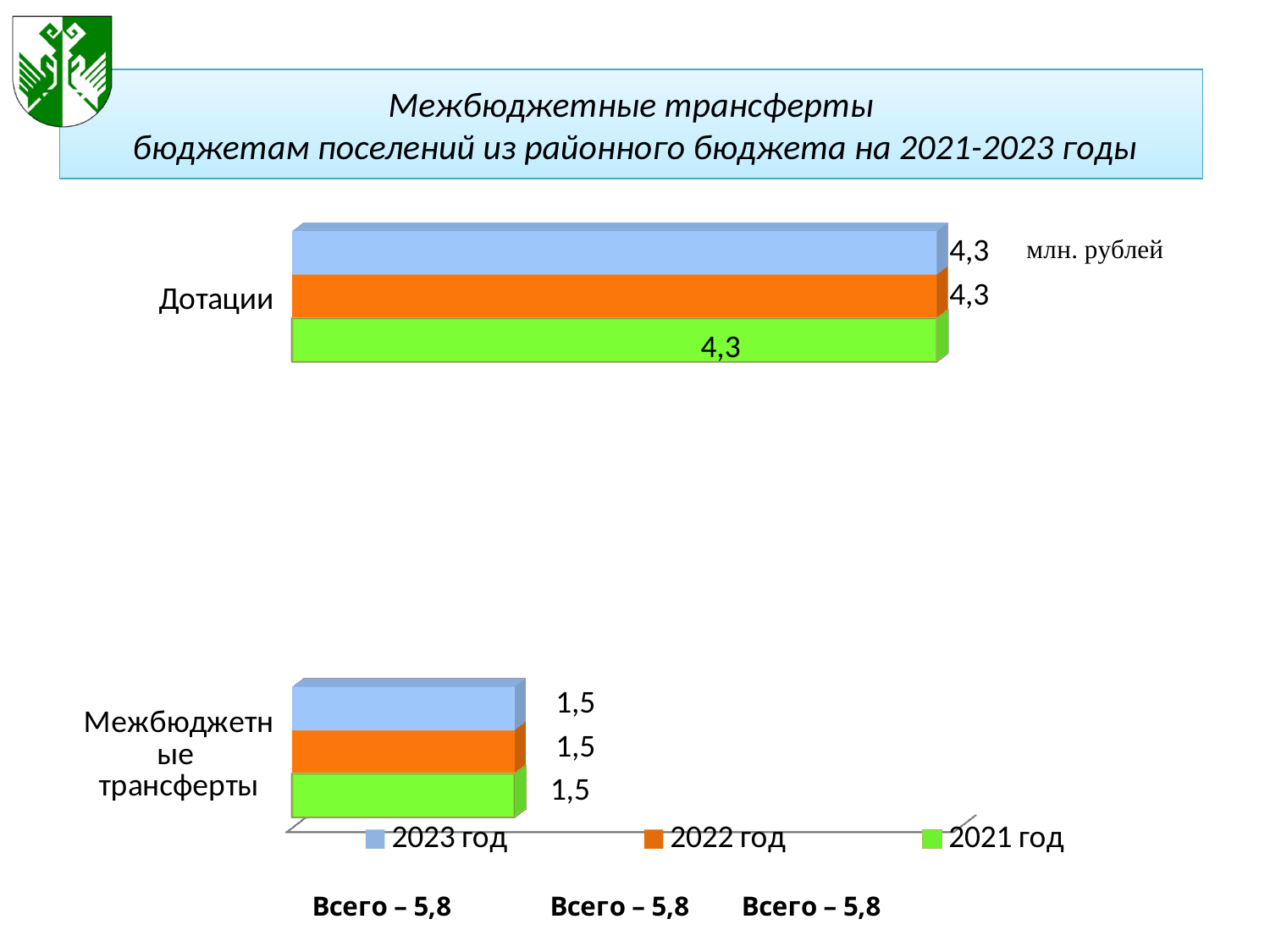
What is the value for Дотации in 2023 год? 4,3 What is the value for Межбюджетные трансферты in 2021 год? 1,5 How many categories are shown on the chart? 2 What is the value for Межбюджетные трансферты in 2022 год? 1,5 Which category has the highest value in 2021 год? Дотации Which category has the lowest value in 2023 год? Межбюджетные трансферты What is the value for Дотации in 2022 год? 4,3 What unit is indicated next to the chart? млн. рублей What kind of chart is shown on the slide? Bar chart What is the difference between Дотации and Межбюджетные трансферты in 2023 год? 2,8 How many series does the legend list? 3 Which is larger in 2022 год: Дотации or Межбюджетные трансферты? Дотации